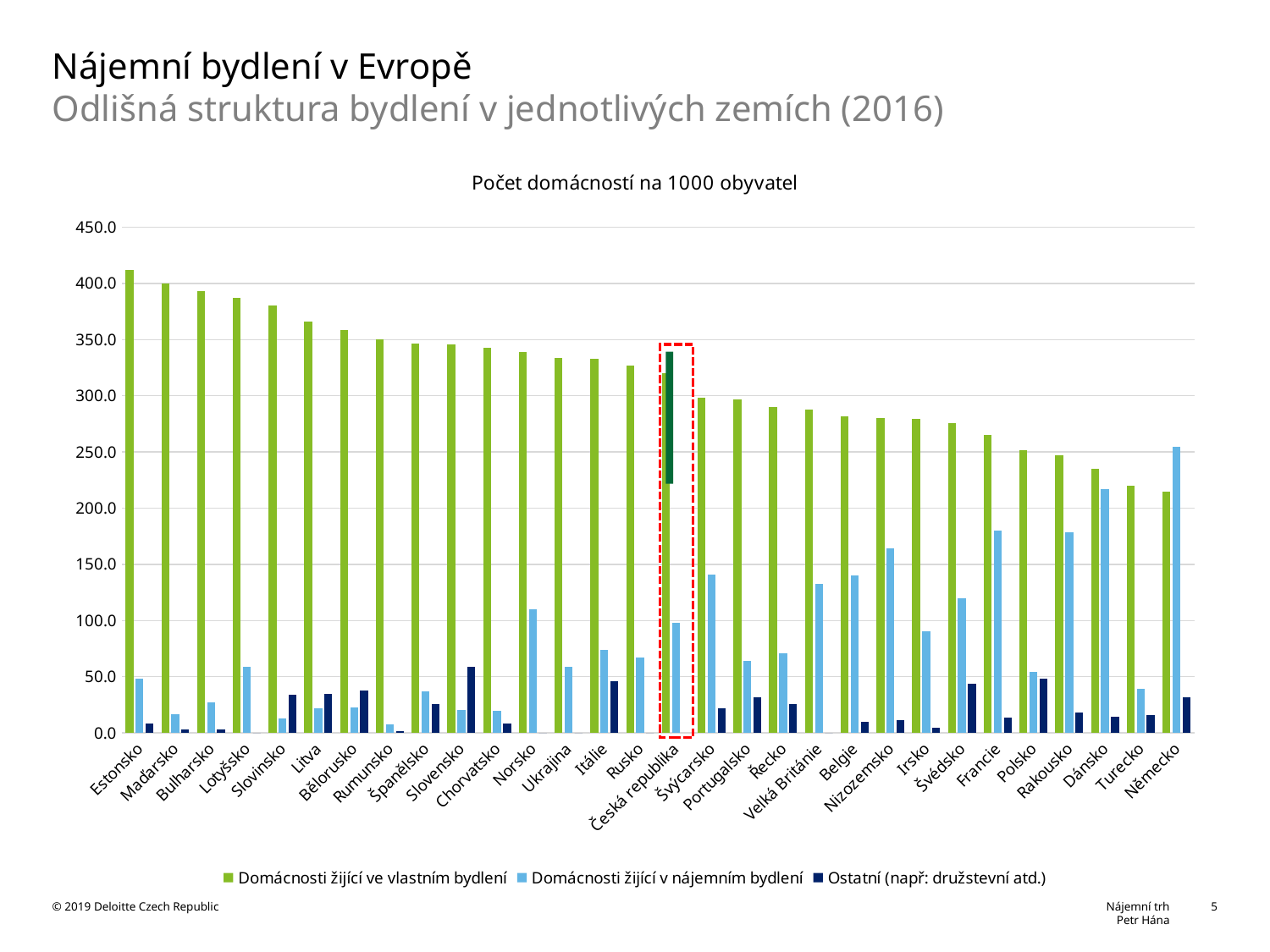
How many countries are shown on the x axis? 30 Is the value for 'Domácnosti žijící ve vlastním bydlení' in Estonsko greater or less than 400? greater Which is larger: 'Domácnosti žijící v nájemním bydlení' in Norsko or in Ukrajina? Norsko Which country has the highest value for 'Domácnosti žijící ve vlastním bydlení'? Estonsko What kind of chart is shown on the slide? bar chart How many series does the legend list? 3 Which country has the highest value for 'Domácnosti žijící v nájemním bydlení'? Německo Do the values for 'Domácnosti žijící ve vlastním bydlení' rise or fall from left to right along the x axis? fall Which country is highlighted with a red dashed box on the chart? Česká republika Is the value for 'Domácnosti žijící ve vlastním bydlení' in Česká republika greater or less than 300? greater Is the value for 'Domácnosti žijící v nájemním bydlení' in Irsko greater or less than 100? less